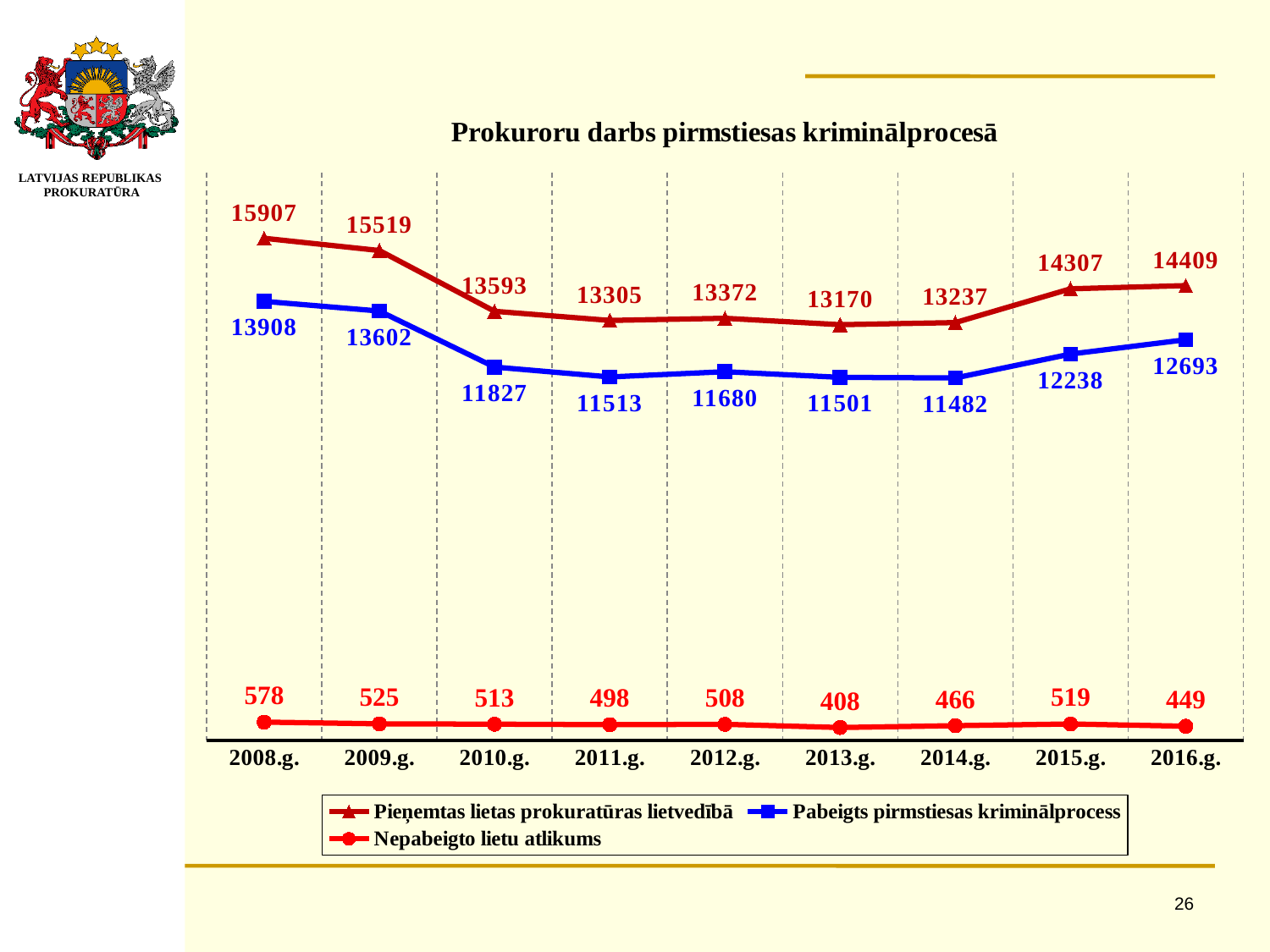
What is the difference between Pieņemtas lietas prokuratūras lietvedībā and Pabeigts pirmstiesas kriminālprocess in 2016.g.? 1716 What is the value of Pieņemtas lietas prokuratūras lietvedībā in 2008.g.? 15907 What is the value of Pabeigts pirmstiesas kriminālprocess in 2016.g.? 12693 How many series does the legend list? 3 Which is larger: Nepabeigto lietu atlikums in 2012.g. or in 2014.g.? 2012.g. What is the title of the chart? Prokuroru darbs pirmstiesas kriminālprocesā In which year is Pieņemtas lietas prokuratūras lietvedībā highest? 2008.g. In which year is Pabeigts pirmstiesas kriminālprocess lowest? 2014.g. In which year is Nepabeigto lietu atlikums highest? 2008.g. What kind of chart is shown on the slide? Line chart How many years are shown on the x axis? 9 What is the value of Nepabeigto lietu atlikums in 2013.g.? 408